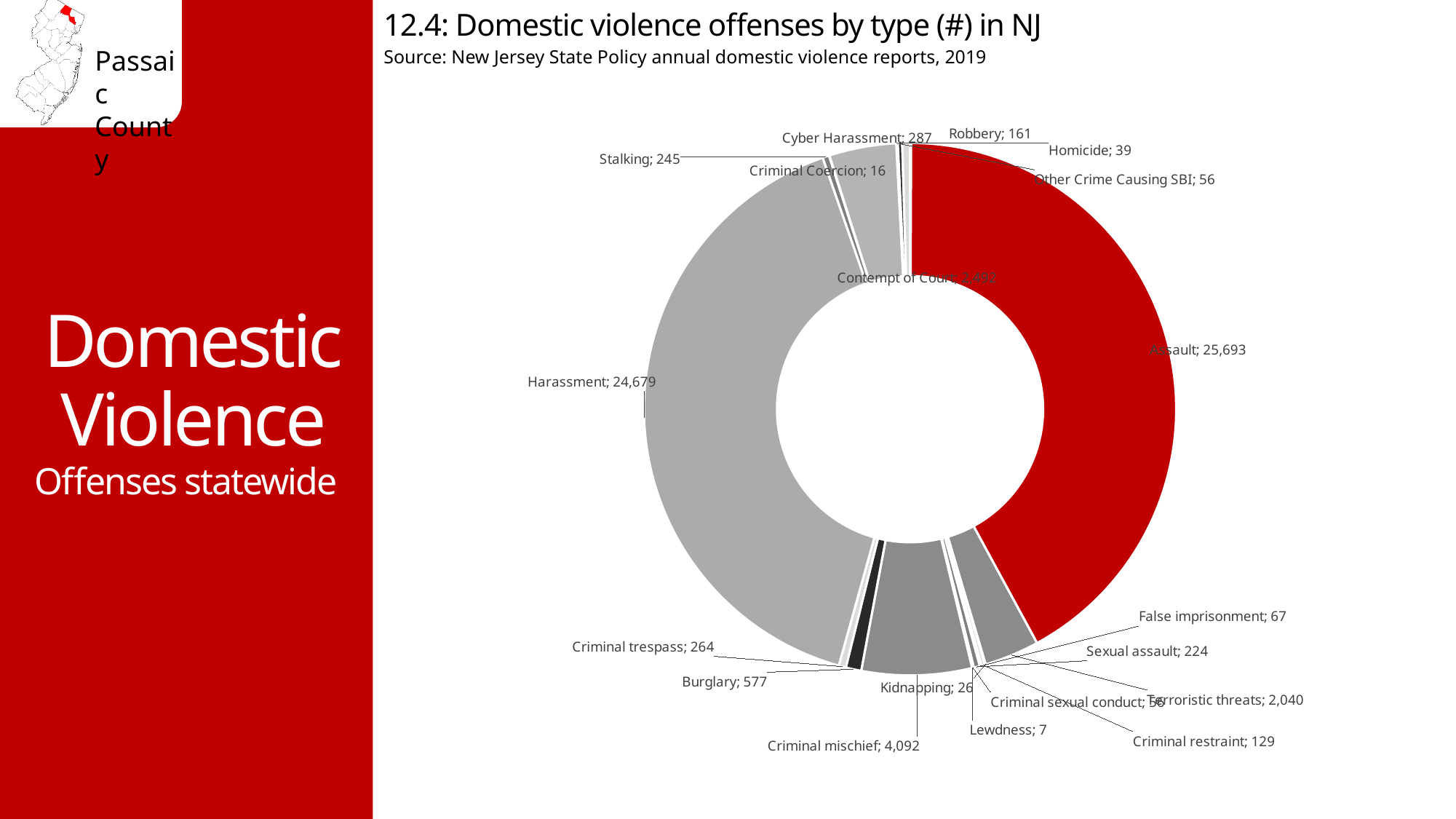
What is the title of the chart? 12.4: Domestic violence offenses by type (#) in NJ What is the value shown for Terroristic threats? 2,040 Which offense type has the lowest number of offenses? Lewdness What is the difference between the Burglary and Criminal trespass values? 313 Which offense type has the highest number of offenses? Assault How many domestic violence offenses of type Assault are shown on the chart? 25,693 What is the value shown for Criminal mischief? 4,092 What is the difference between the Assault and Harassment values? 1,014 What is the value shown for Harassment? 24,679 What is the value shown for Burglary? 577 What kind of chart is shown on the slide? Doughnut (pie) chart Which is larger, Cyber Harassment or Stalking? Cyber Harassment